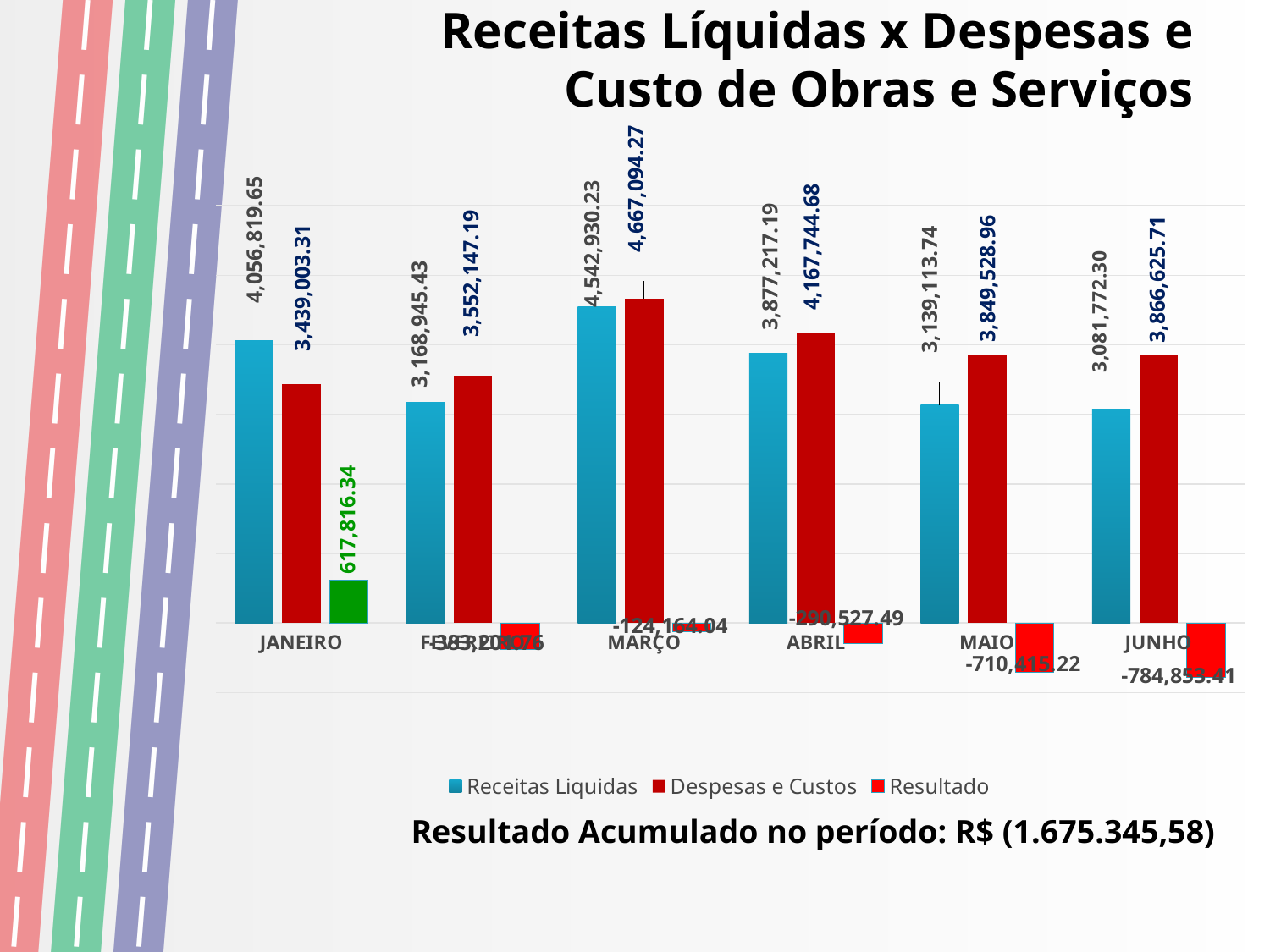
What is the value of Despesas e Custos for MARÇO? 4,667,094.27 What kind of chart is shown on the slide? bar chart What is the value of Receitas Liquidas for JANEIRO? 4,056,819.65 How many series does the legend list? 3 What is the difference between Receitas Liquidas and Despesas e Custos in JANEIRO? 617,816.34 Which month has the lowest Receitas Liquidas? JUNHO How many months are shown on the x axis? 6 What is the Resultado Acumulado no período stated below the chart? R$ (1.675.345,58) In JANEIRO, which is larger: Receitas Liquidas or Despesas e Custos? Receitas Liquidas What is the Resultado value for JANEIRO? 617,816.34 What is the value of Receitas Liquidas for ABRIL? 3,877,217.19 Which month has the highest Receitas Liquidas? MARÇO